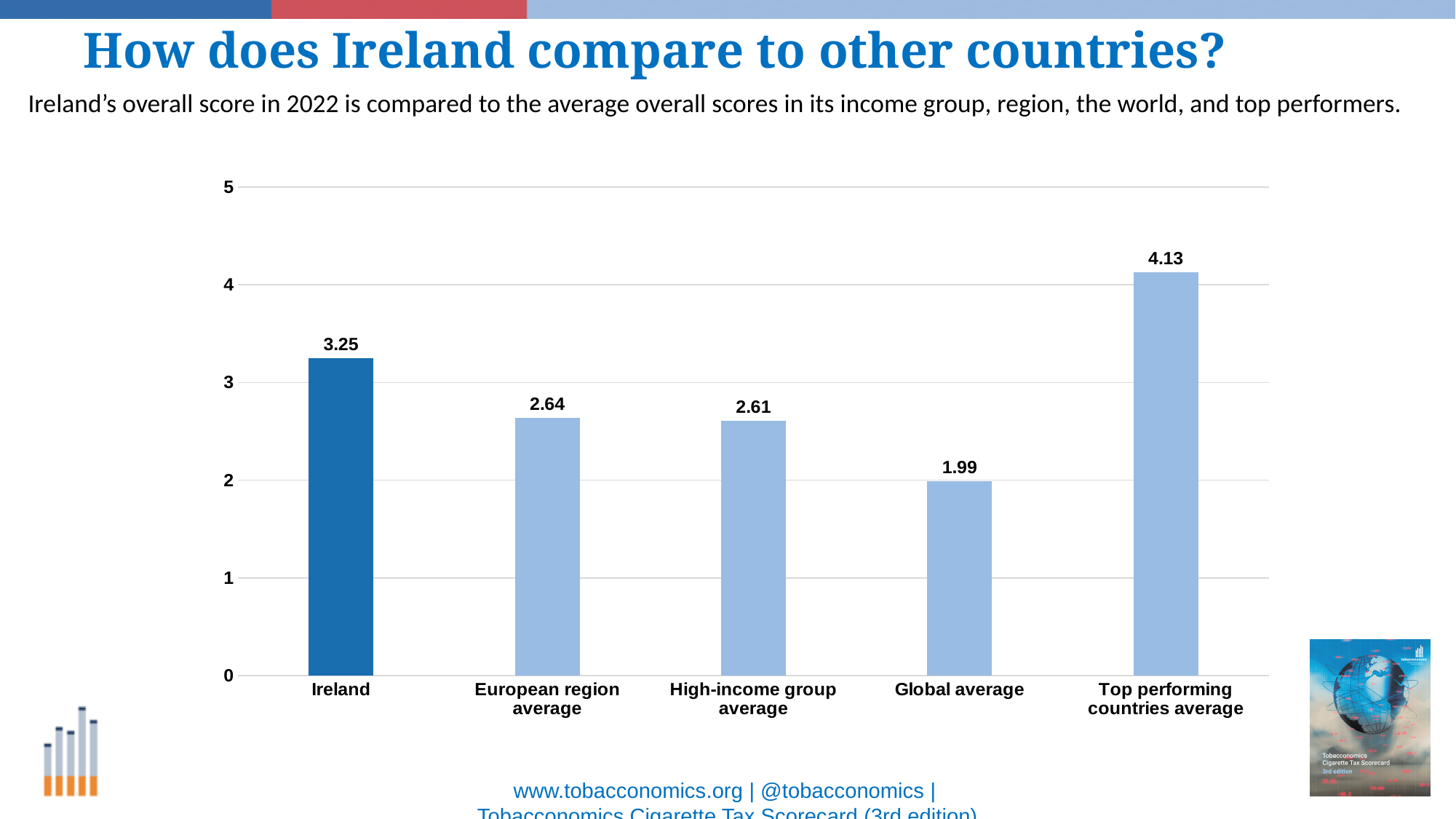
What is the difference between the Top performing countries average and Ireland's score? 0.88 What is the overall score shown for Ireland? 3.25 Which category has the highest value? Top performing countries average What is the value shown for the Top performing countries average? 4.13 What kind of chart is shown on the slide? Bar chart Is the value for Ireland greater or less than 3? greater How many categories are shown on the chart? 5 What is the value shown for the Global average? 1.99 Which category has the lowest value? Global average What is the value shown for the High-income group average? 2.61 Which is larger, the value for Ireland or the Global average? Ireland What is the difference between Ireland's score and the European region average? 0.61